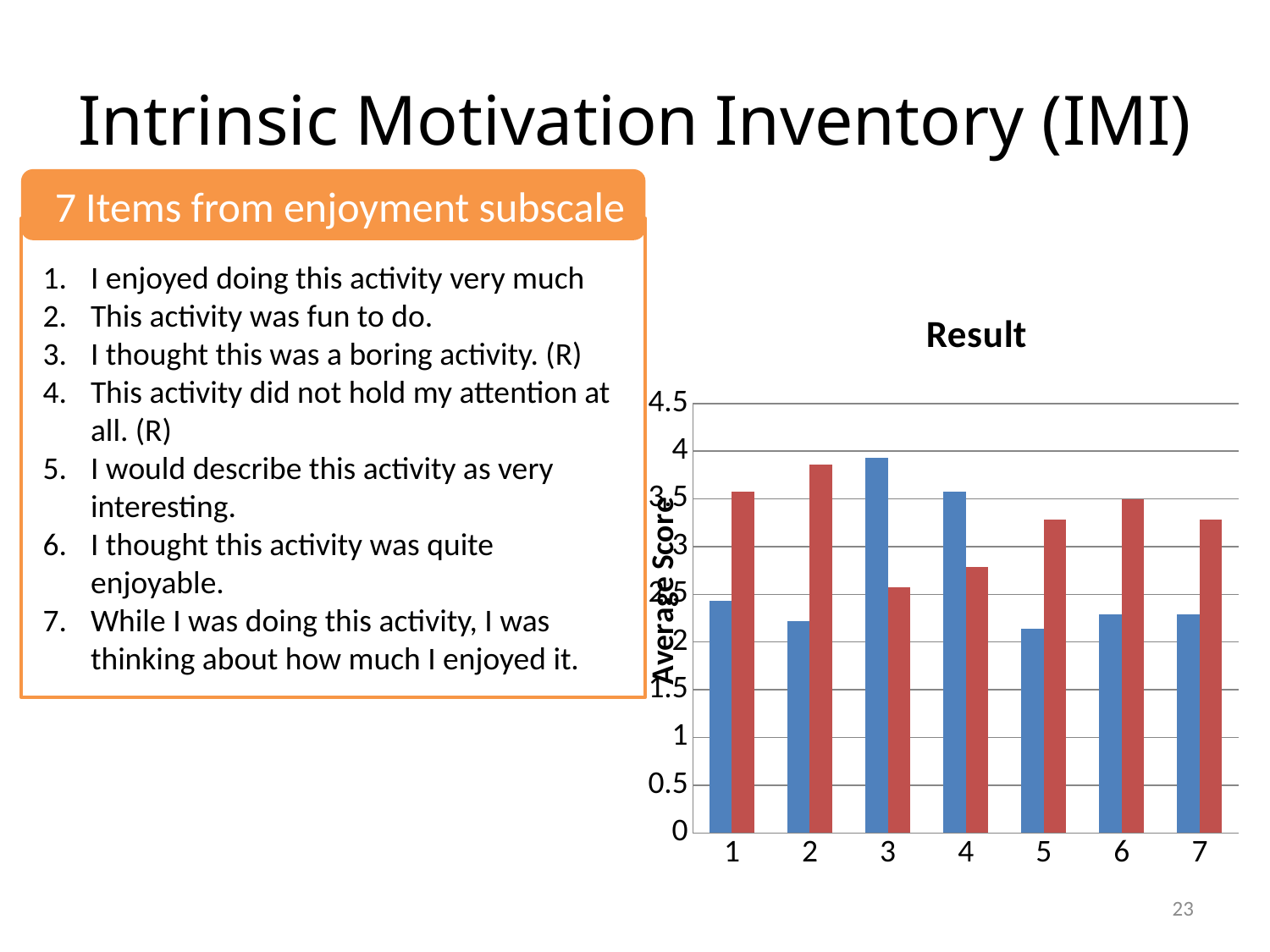
For which category is the red bar the tallest? 2 Is the blue bar for category 3 greater or less than 3.5? greater Is the blue bar for category 5 greater or less than 2.5? less What is the label on the vertical axis of the chart? Average Score For which category is the red bar the shortest? 3 For category 1, which bar is taller, the blue one or the red one? red Is the red bar for category 3 greater or less than 3? less For which category is the blue bar the tallest? 3 How many categories are shown on the x axis of the chart? 7 How many bars are plotted for each category in the chart? 2 What is the title of the chart? Result What kind of chart is shown on the slide? bar chart